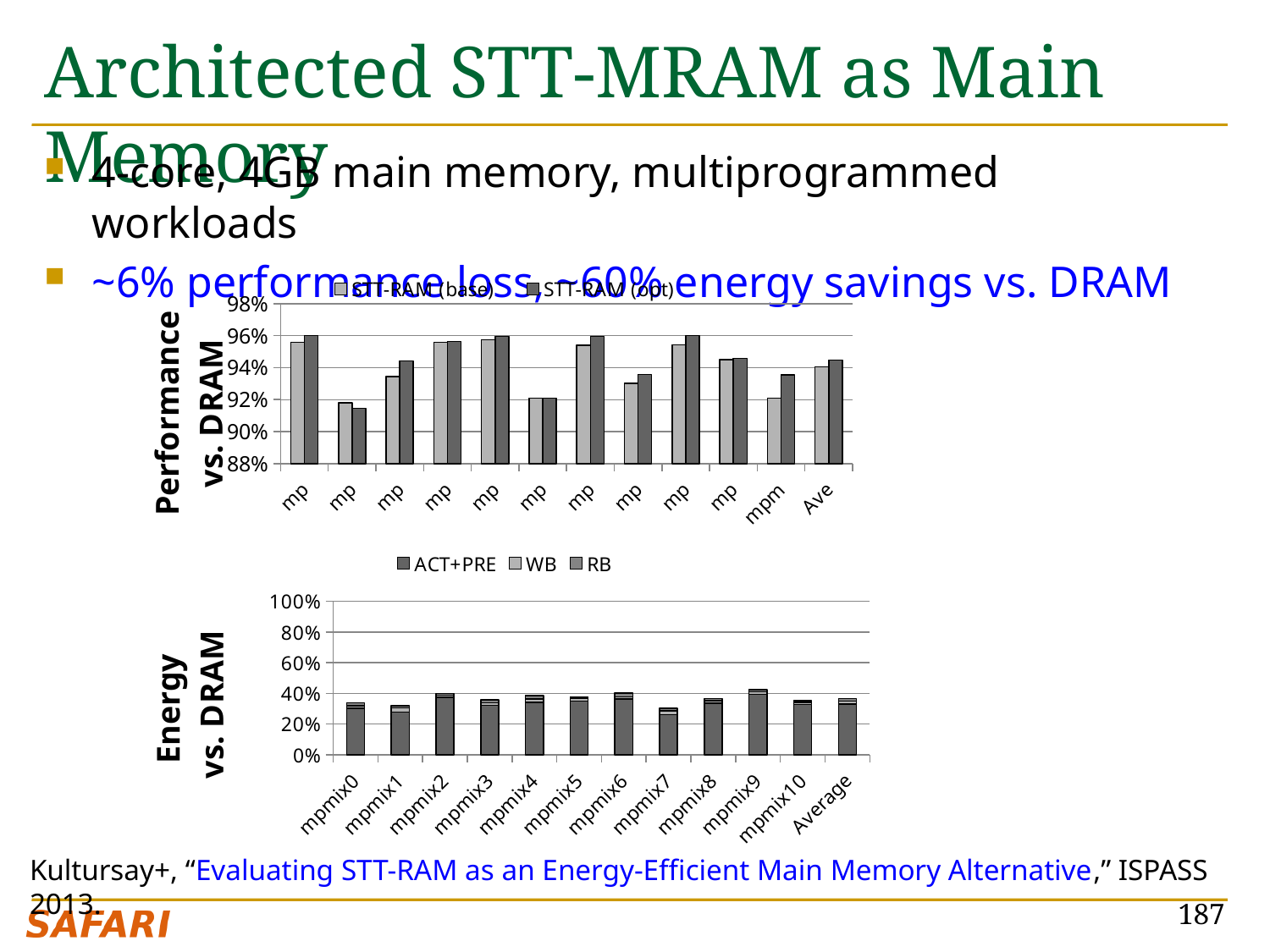
How many categories are shown on the x axis of the bottom chart (Energy vs. DRAM)? 12 In the top chart (Performance vs. DRAM), for mpm, which series has the larger value: STT-RAM (base) or STT-RAM (opt)? STT-RAM (opt) In the bottom chart (Energy vs. DRAM), is the total for mpmix7 greater or less than 40%? less What are the legend entries of the bottom chart (Energy vs. DRAM)? ACT+PRE, WB, RB In the bottom chart (Energy vs. DRAM), is the total for mpmix1 greater or less than 40%? less In the top chart (Performance vs. DRAM), is the STT-RAM (base) value for mpm greater or less than 94%? less How many series does the legend of the bottom chart (Energy vs. DRAM) list? 3 How many series does the legend of the top chart (Performance vs. DRAM) list? 2 What kind of chart is the bottom chart (Energy vs. DRAM)? bar chart How many categories are shown on the x axis of the top chart (Performance vs. DRAM)? 12